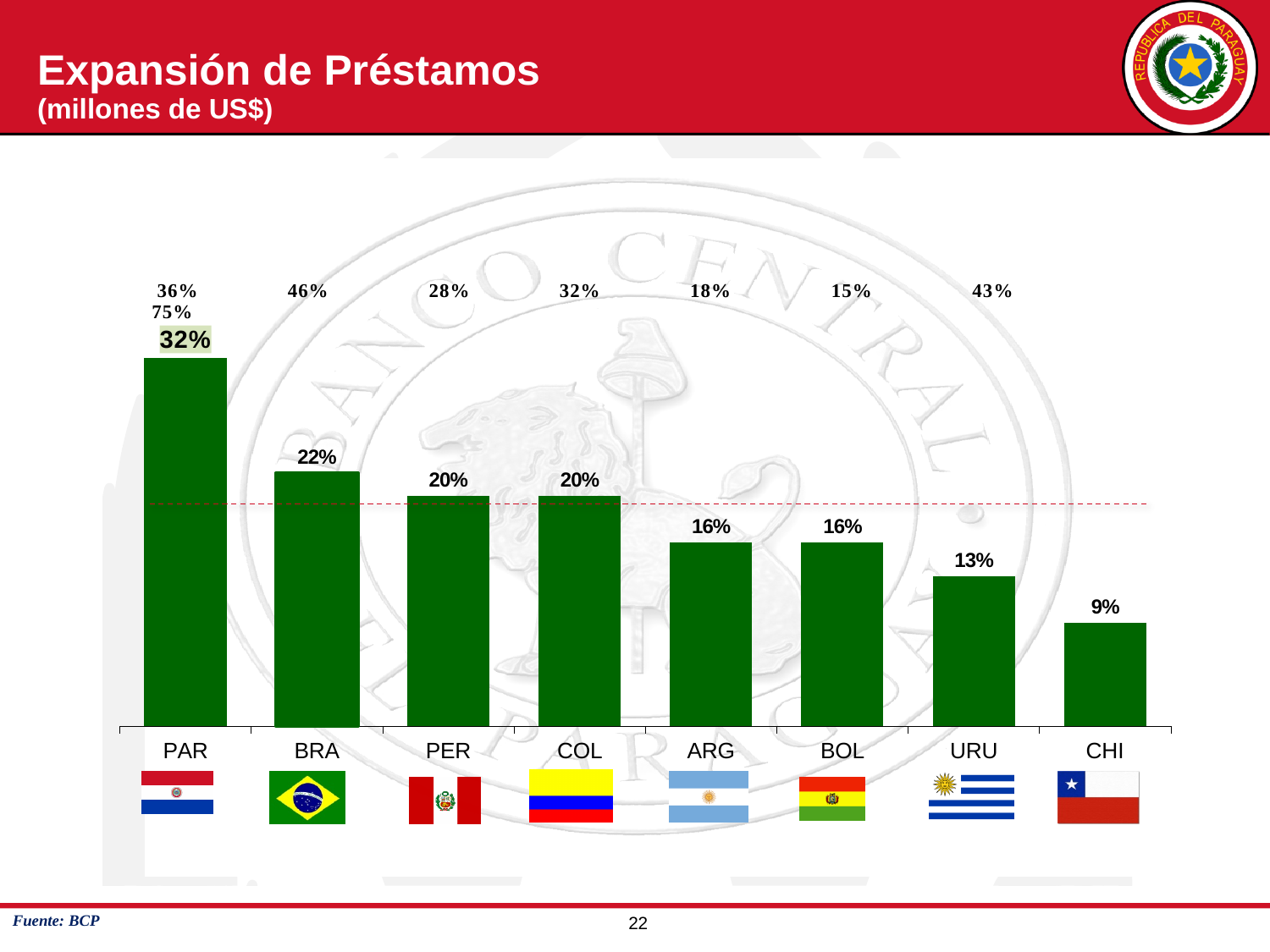
What is the value shown for PAR? 32% What is the difference between the values for PAR and BRA? 10% Which country has the highest bar? PAR What is the value shown for URU? 13% What is the value shown for CHI? 9% How many countries are shown on the x axis? 8 What is the value shown for BRA? 22% What is the title of the chart on the slide? Expansión de Préstamos (millones de US$) Which country has the lowest bar? CHI Which is larger, the value for ARG or the value for URU? ARG Do the bar values rise or fall from left to right across the x axis? Fall What kind of chart is shown on the slide? Bar chart